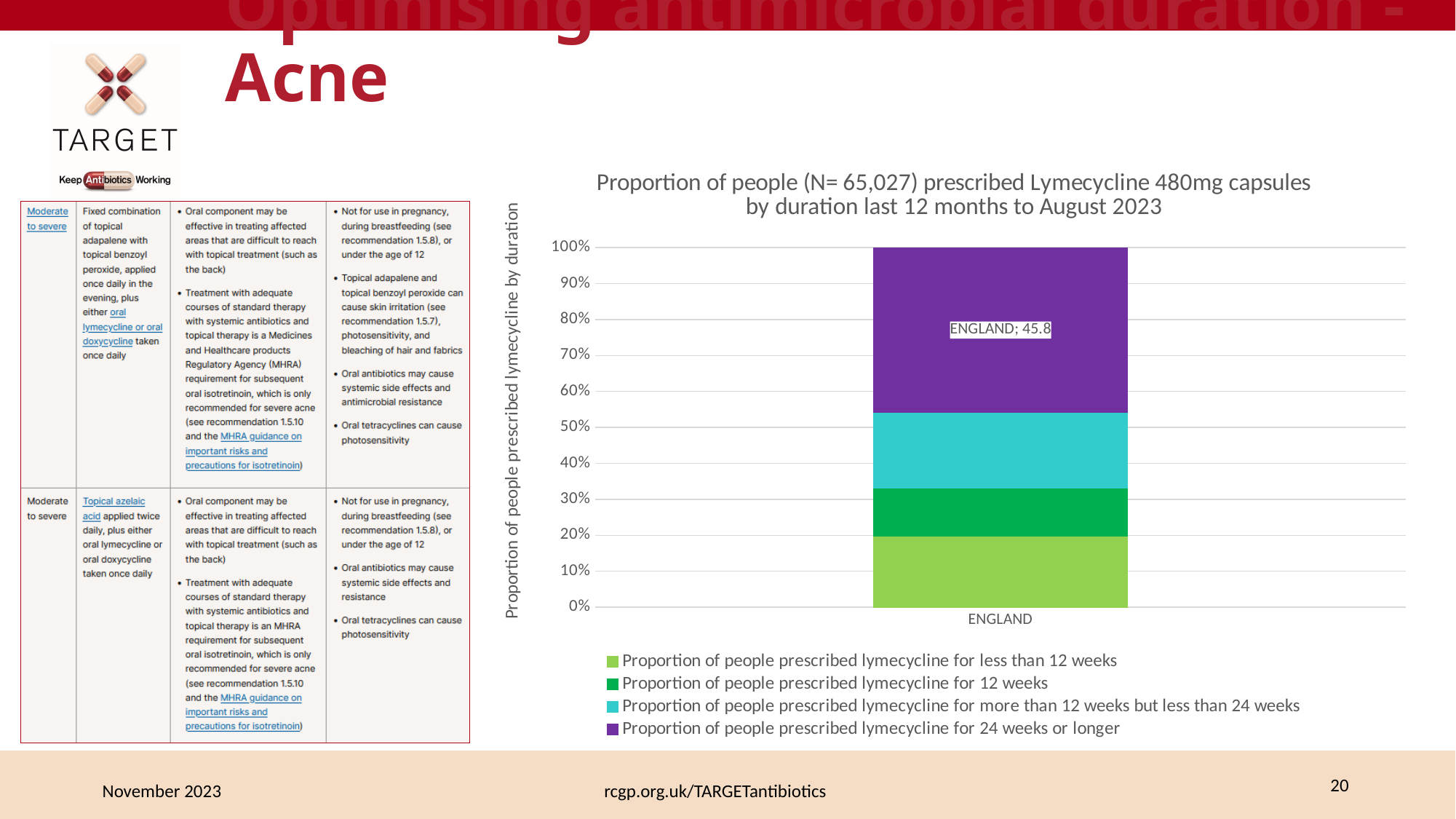
Is the segment for people prescribed lymecycline for more than 12 weeks but less than 24 weeks greater or less than 10%? greater Which segment is larger in the ENGLAND bar: lymecycline for 24 weeks or longer or lymecycline for more than 12 weeks but less than 24 weeks? Lymecycline for 24 weeks or longer How many categories are plotted on the x axis of the chart? 1 What kind of chart is shown on the slide? Stacked bar chart What colour represents 'Proportion of people prescribed lymecycline for 24 weeks or longer' in the chart legend? Purple How many series does the chart legend list? 4 Which duration series makes up the smallest segment of the ENGLAND bar? Proportion of people prescribed lymecycline for 12 weeks What value is printed on the data label for the 'Proportion of people prescribed lymecycline for 24 weeks or longer' segment of the ENGLAND bar? 45.8 Is the segment for people prescribed lymecycline for less than 12 weeks greater or less than 10%? greater Which segment is larger in the ENGLAND bar: lymecycline for less than 12 weeks or lymecycline for 12 weeks? Lymecycline for less than 12 weeks What is the label on the y axis of the chart? Proportion of people prescribed lymecycline by duration Which duration series makes up the largest segment of the ENGLAND bar? Proportion of people prescribed lymecycline for 24 weeks or longer